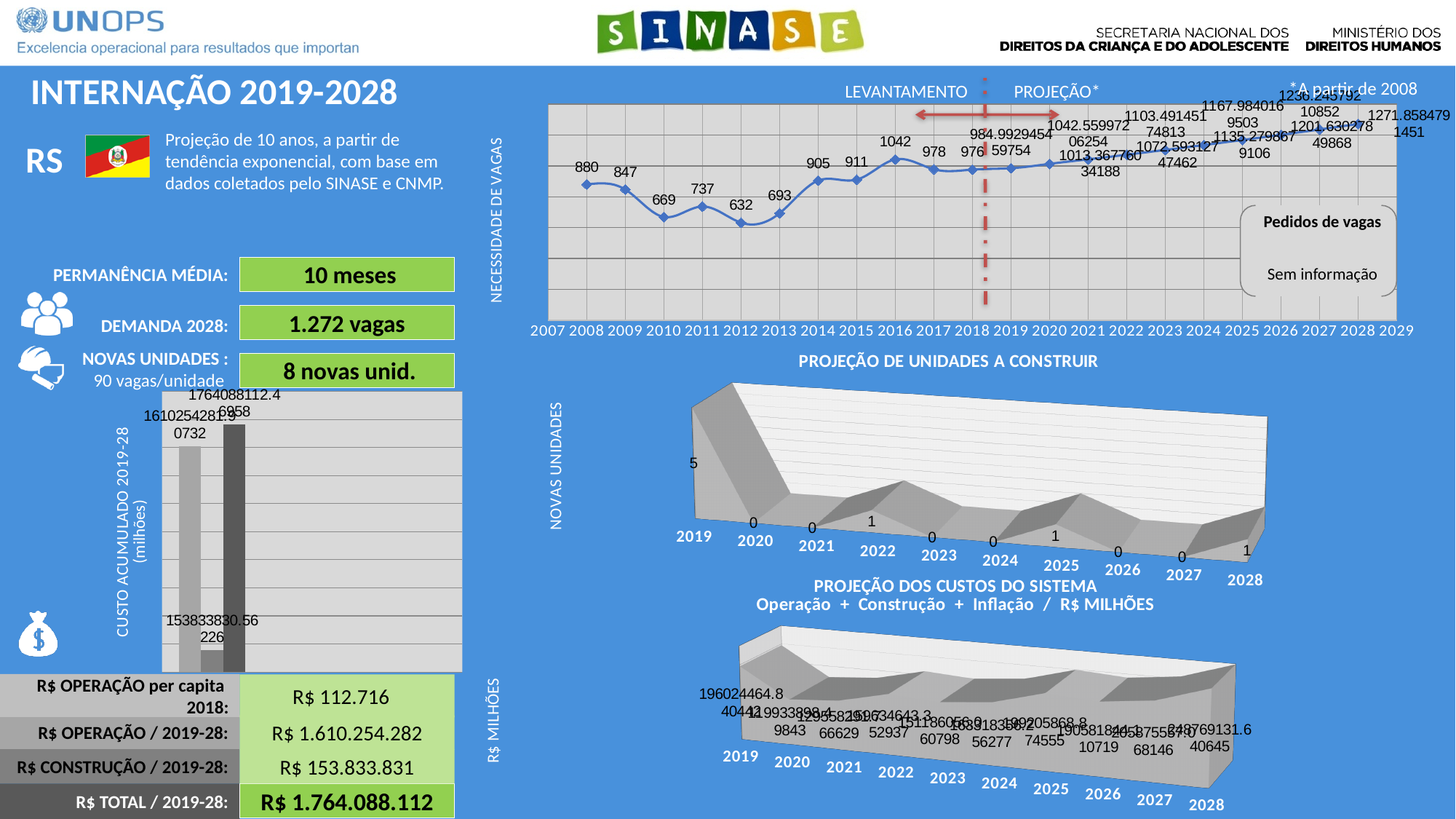
What kind of chart is the top-right chart (NECESSIDADE DE VAGAS)? line chart In the top-right line chart (NECESSIDADE DE VAGAS), what is the value for 2012? 632 In the top-right line chart (NECESSIDADE DE VAGAS), which is larger, the value for 2014 or the value for 2015? 2015 In the top-right line chart (NECESSIDADE DE VAGAS), what is the value for 2016? 1042 In the top-right line chart (NECESSIDADE DE VAGAS), do the values rise or fall from 2013 to 2016? rise In the top-right line chart (NECESSIDADE DE VAGAS), what is the difference between the values for 2008 and 2009? 33 In the top-right line chart (NECESSIDADE DE VAGAS), which year has the highest value? 2028 In the chart titled PROJEÇÃO DE UNIDADES A CONSTRUIR, how many years are shown on the x axis? 10 In the top-right line chart (NECESSIDADE DE VAGAS), what is the value for 2008? 880 In the chart titled PROJEÇÃO DE UNIDADES A CONSTRUIR, what is the value for 2019? 5 In the chart titled PROJEÇÃO DE UNIDADES A CONSTRUIR, which year has the highest value? 2019 In the top-right line chart (NECESSIDADE DE VAGAS), which year has the lowest value? 2012